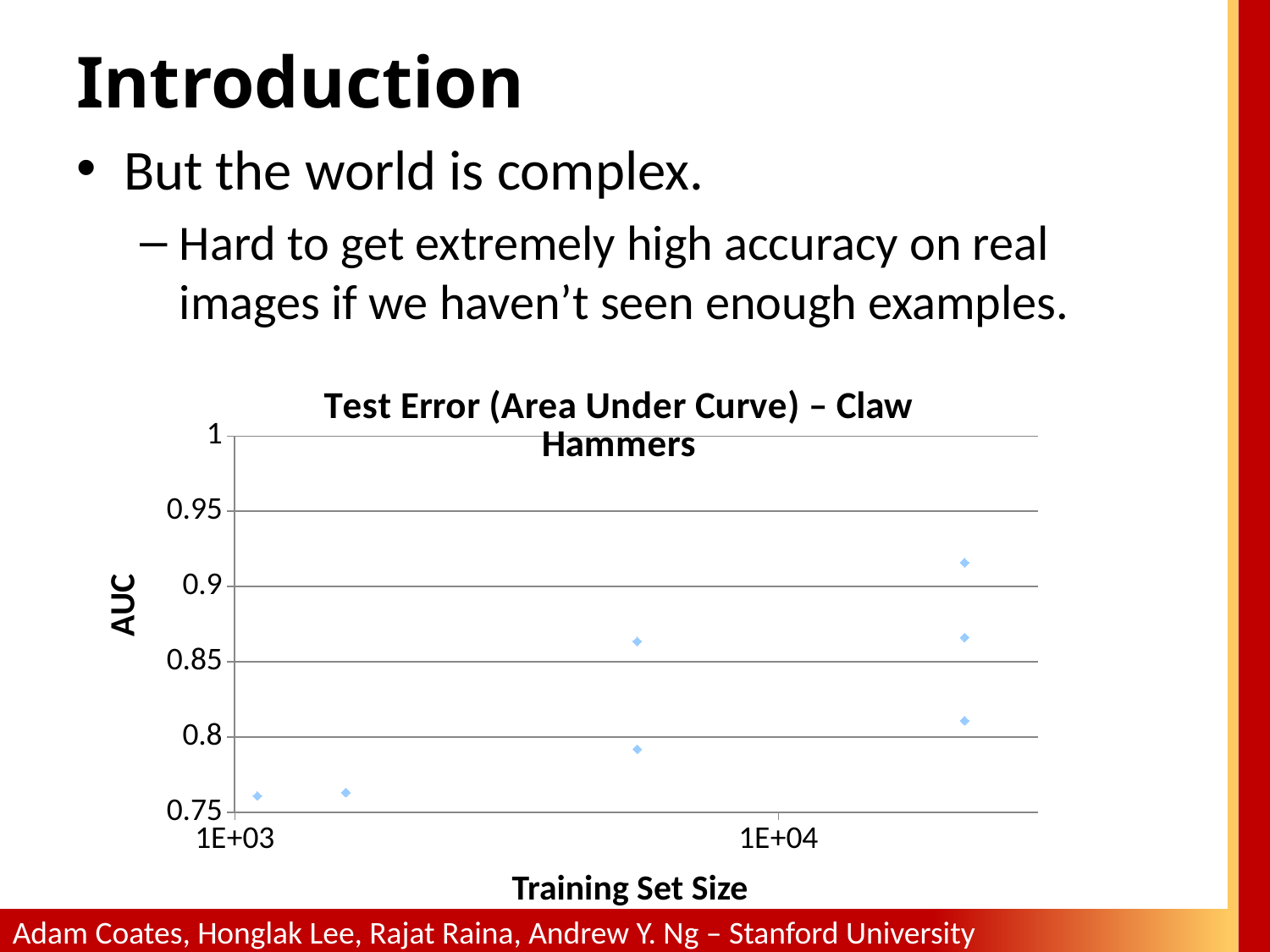
What is the title of the chart? Test Error (Area Under Curve) – Claw Hammers Is the AUC of the point plotted at a training set size of 1E+03 greater or less than 0.8? less How many data points are plotted in the chart? 7 What is the label of the x axis? Training Set Size Is the highest plotted AUC value greater or less than 0.95? less What kind of chart is shown on the slide? scatter plot Are the points with the largest training set size higher or lower in AUC than the points near 1E+03? higher Is the lowest plotted AUC value greater or less than 0.8? less Do the AUC values generally rise or fall as the training set size increases? rise